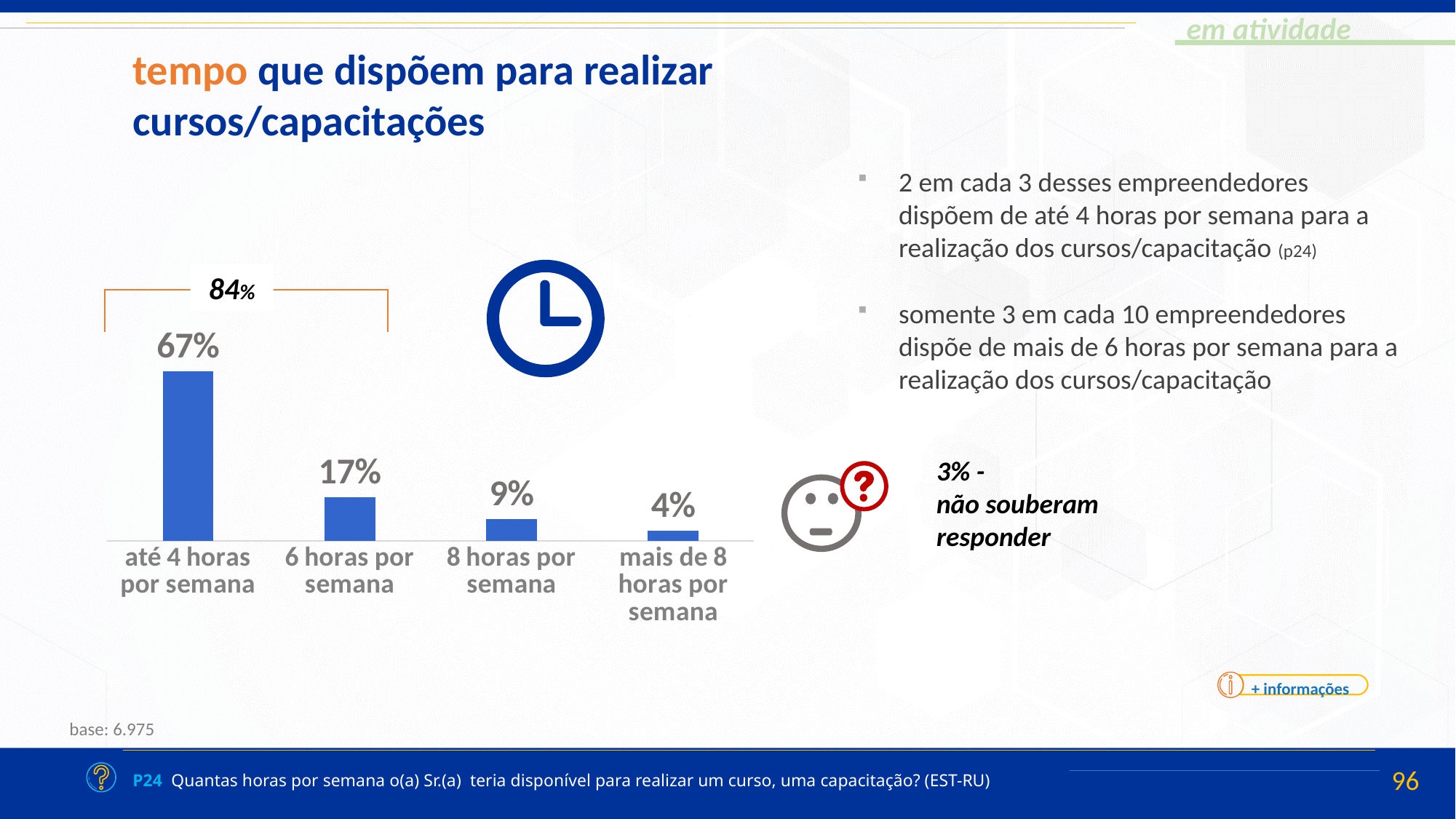
What percentage is shown by the bracket spanning the first two bars? 84% What is the value for 'mais de 8 horas por semana'? 4% Which category has the lowest value? mais de 8 horas por semana What kind of chart is shown on the slide? bar chart Which is larger, the value for '6 horas por semana' or '8 horas por semana'? 6 horas por semana What is the difference between the values for 'até 4 horas por semana' and '6 horas por semana'? 50% Which category has the highest value? até 4 horas por semana What is the value for '6 horas por semana'? 17% How many categories are shown in the chart? 4 What is the difference between the values for '8 horas por semana' and 'mais de 8 horas por semana'? 5% What is the value for '8 horas por semana'? 9% What is the value for 'até 4 horas por semana'? 67%